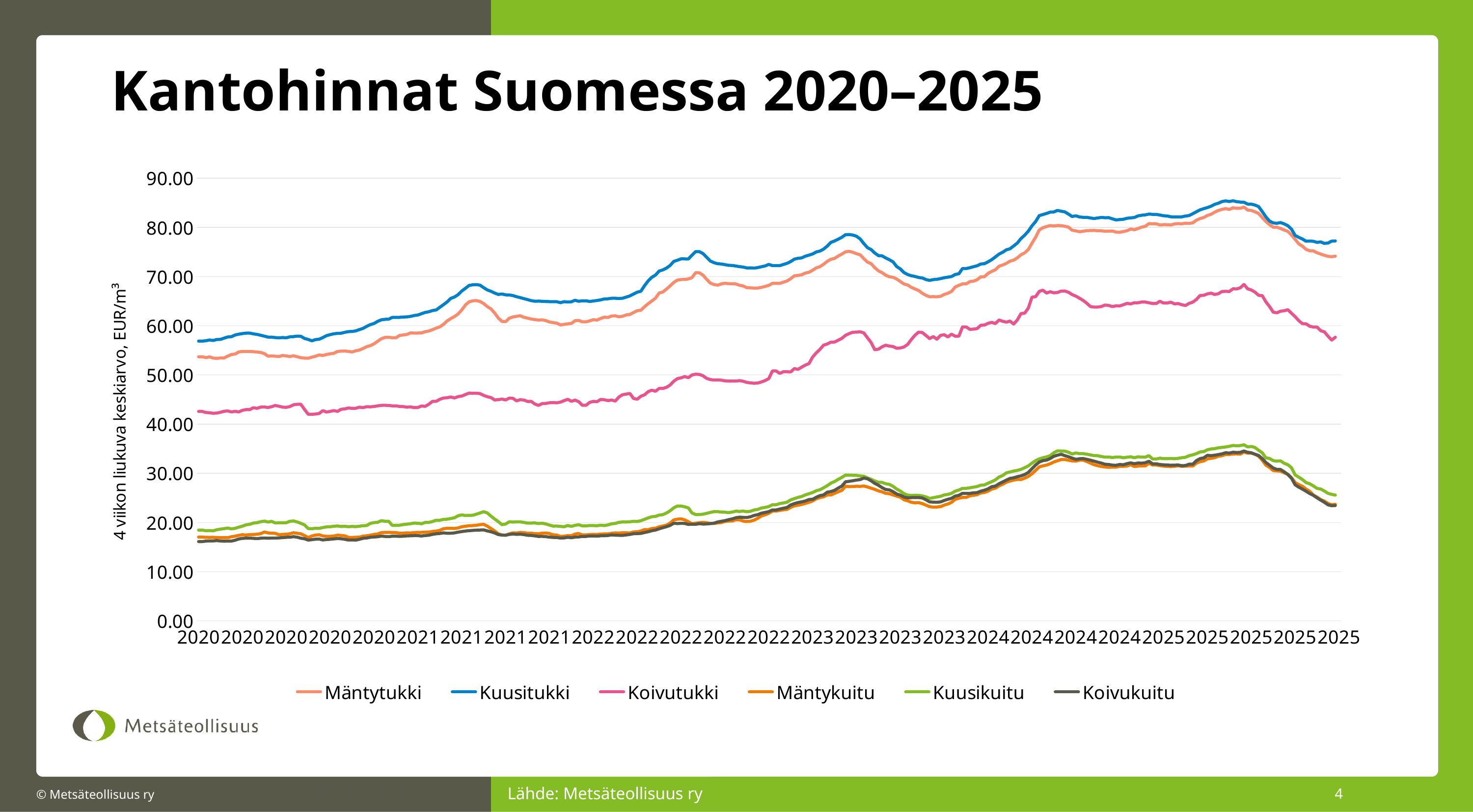
Which series has the highest values across the whole period? Kuusitukki What kind of chart is shown on the slide? Line chart Which series is higher throughout the period, Kuusitukki or Koivutukki? Kuusitukki Overall, do the Koivutukki values rise or fall from 2020 to 2025? rise Is the peak value of Kuusitukki in 2025 greater or less than 80? greater Is the value for Mäntytukki at the start of 2020 greater or less than 50? greater Is the highest value reached by Kuusikuitu greater or less than 40? less What is the title of the chart? Kantohinnat Suomessa 2020–2025 What is the label of the vertical axis? 4 viikon liukuva keskiarvo, EUR/m³ How many series does the legend list? 6